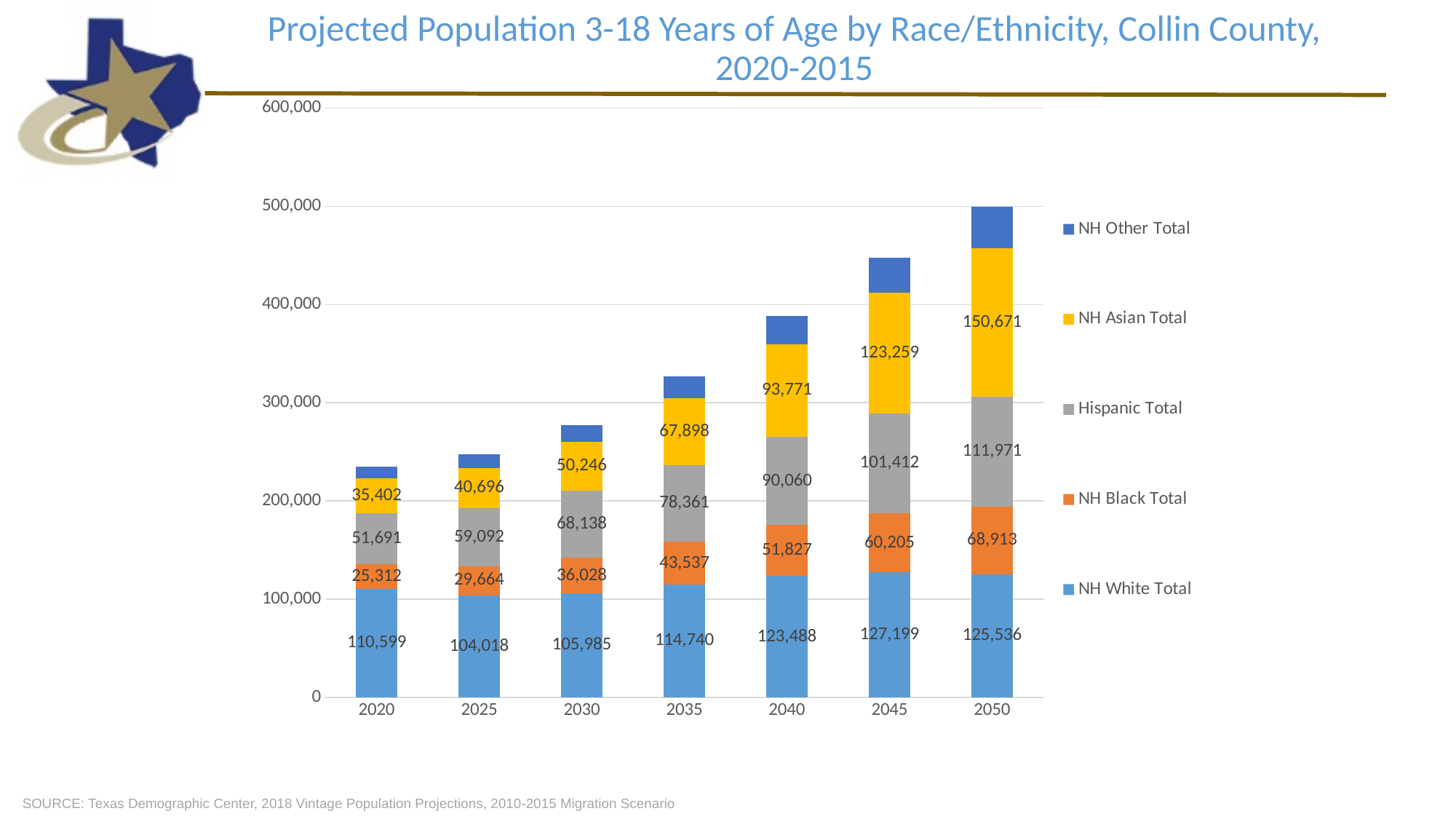
In which year is the NH White Total lowest? 2025 What is the NH Asian Total value for 2050? 150,671 What is the difference between the NH Asian Total in 2050 and in 2020? 115,269 Does the NH Asian Total rise or fall from 2020 to 2050? rise How many series does the legend list? 5 What is the NH White Total value for 2020? 110,599 What is the Hispanic Total value for 2040? 90,060 In 2040, which is larger: the Hispanic Total or the NH Asian Total? NH Asian Total In which year is the NH Asian Total highest? 2050 Is the total height of the 2050 stacked bar greater or less than 400,000? greater What is the NH Black Total value for 2035? 43,537 How many years are shown on the x axis? 7